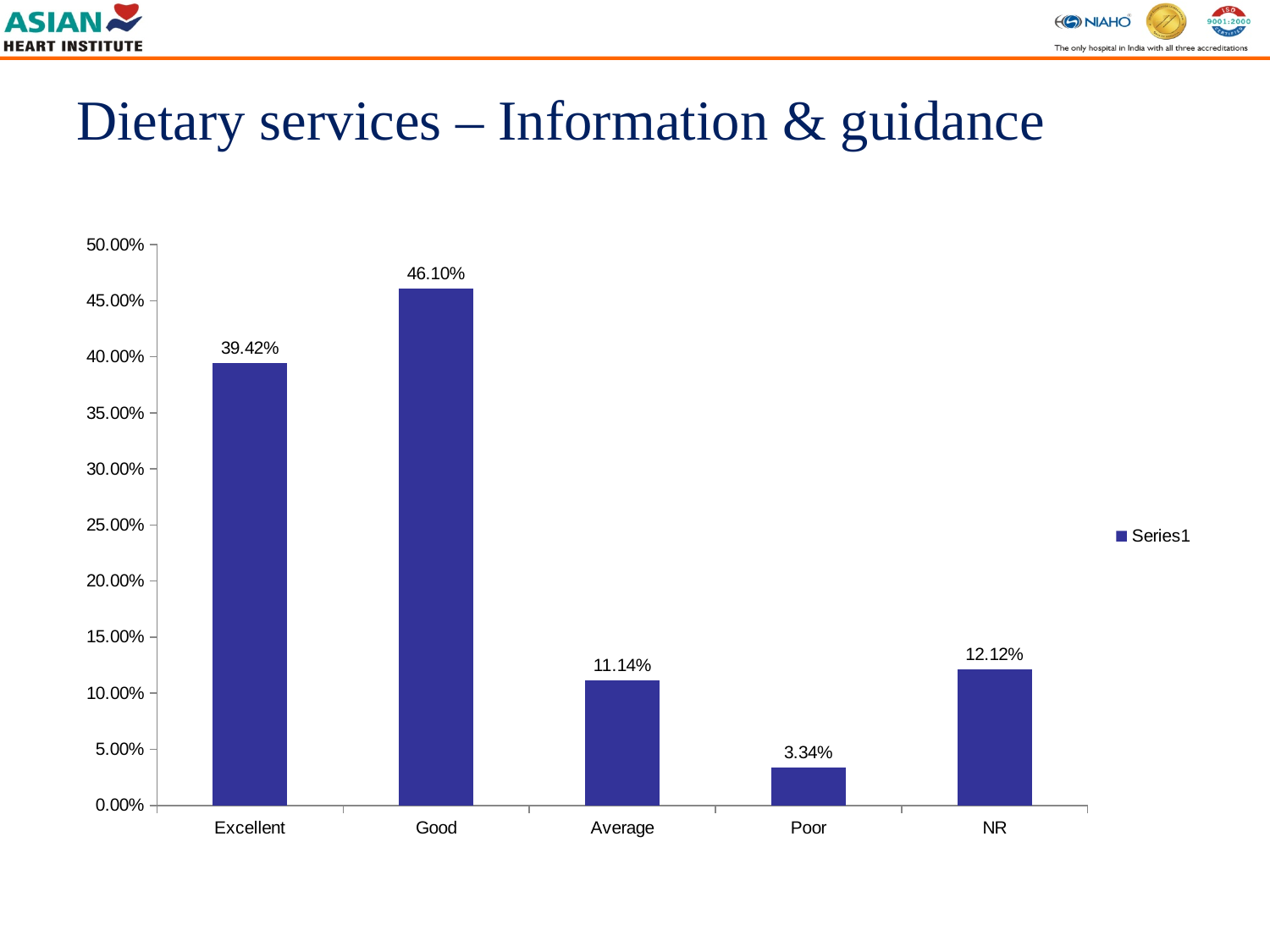
How many categories are shown on the x axis? 5 Which category has the lowest value? Poor What is the value for NR? 12.12% What kind of chart is shown on the slide? bar chart What is the value for Good? 46.10% Which category has the highest value? Good What is the value for Poor? 3.34% What is the value for Excellent? 39.42% What is the difference between the values for Good and Excellent? 6.68% Is the value for Average greater or less than 15.00%? less How many series does the legend list? 1 Which is larger, the value for Average or the value for NR? NR